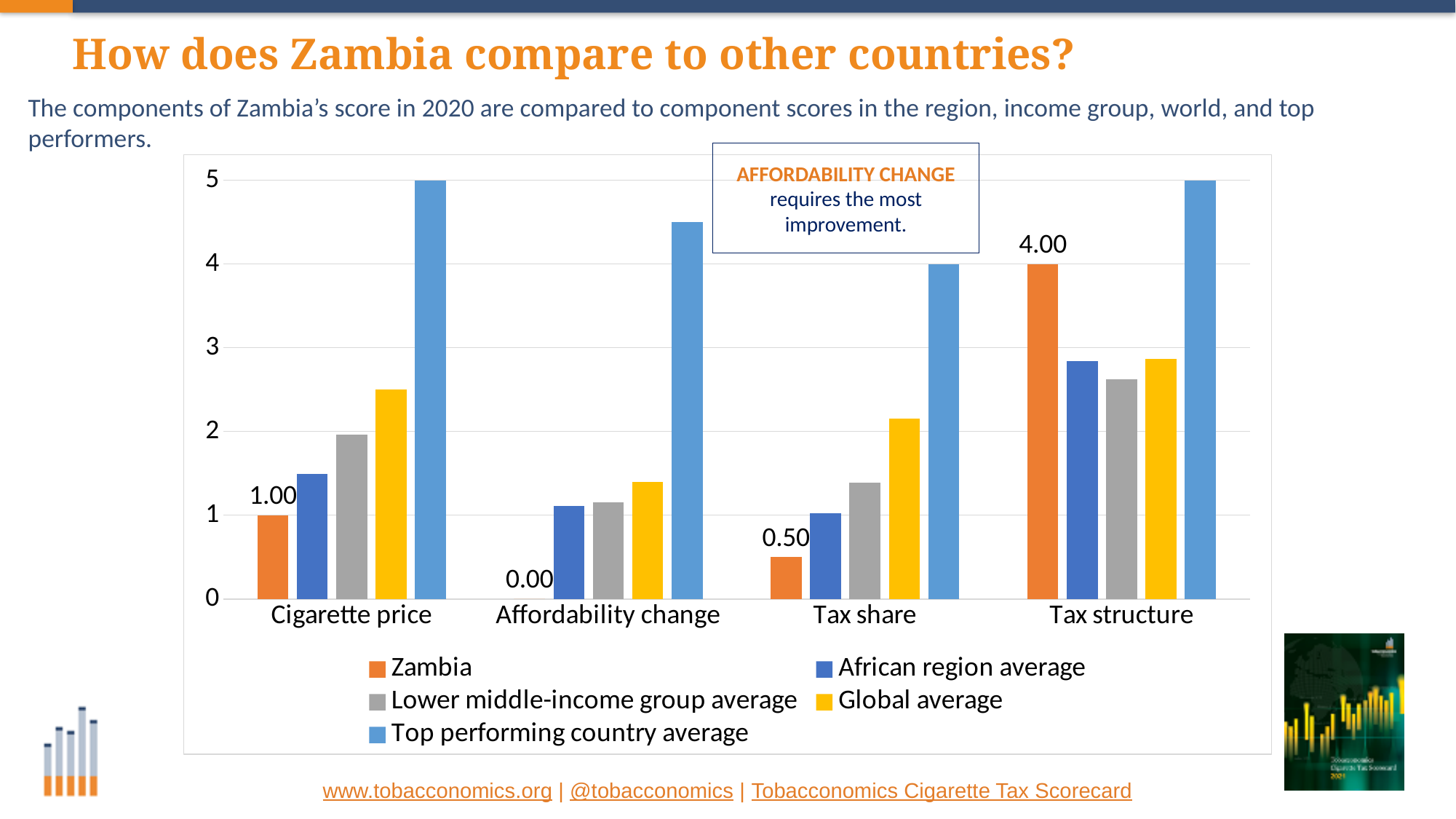
How many series does the legend list? 5 How many categories are shown on the x axis? 4 For Tax structure, which is larger: Zambia's score or the Global average? Zambia's score What is Zambia's score for Tax share? 0.50 What is Zambia's score for Affordability change? 0.00 Is the Top performing country average for Affordability change greater or less than 4? greater What is Zambia's score for Tax structure? 4.00 In which category does Zambia have its highest score? Tax structure What kind of chart is shown on the slide? Bar chart In which category does Zambia have its lowest score? Affordability change What is the difference between Zambia's Tax structure score and its Cigarette price score? 3.00 What is the Top performing country average for Cigarette price? 5